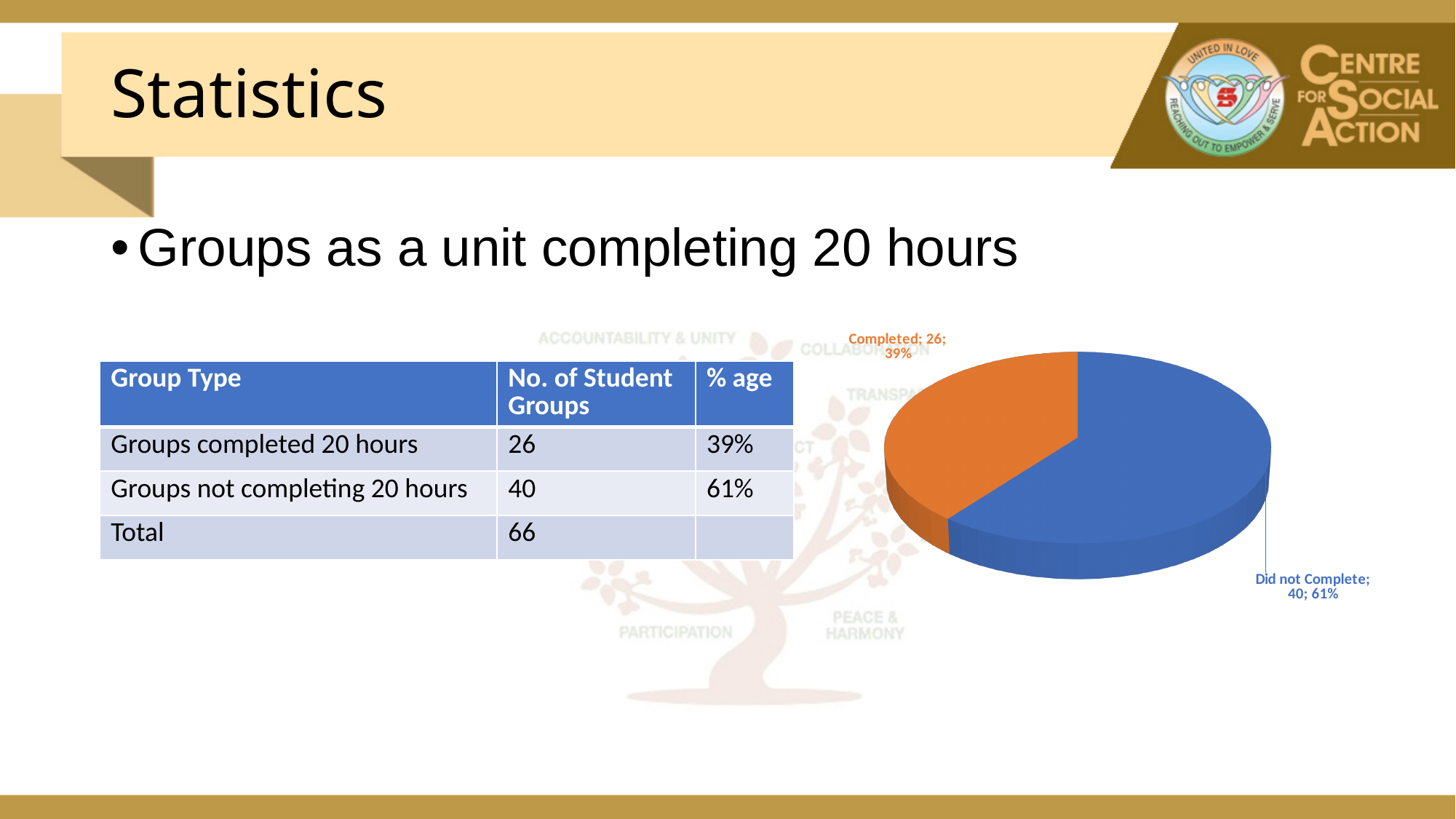
Which slice of the pie chart is the largest? Did not Complete What is the total of the two slice values in the pie chart? 66 What colour is the Did not Complete slice of the pie chart? Blue How many slices does the pie chart have? 2 Which slice of the pie chart is the smallest? Completed What is the difference between the Did not Complete value and the Completed value? 14 What kind of chart is shown on the slide? Pie chart What percentage share does the Completed slice represent? 39% What percentage share does the Did not Complete slice represent? 61% What is the value shown for the Did not Complete slice of the pie chart? 40 Which is larger, the Completed slice or the Did not Complete slice? Did not Complete What is the value shown for the Completed slice of the pie chart? 26